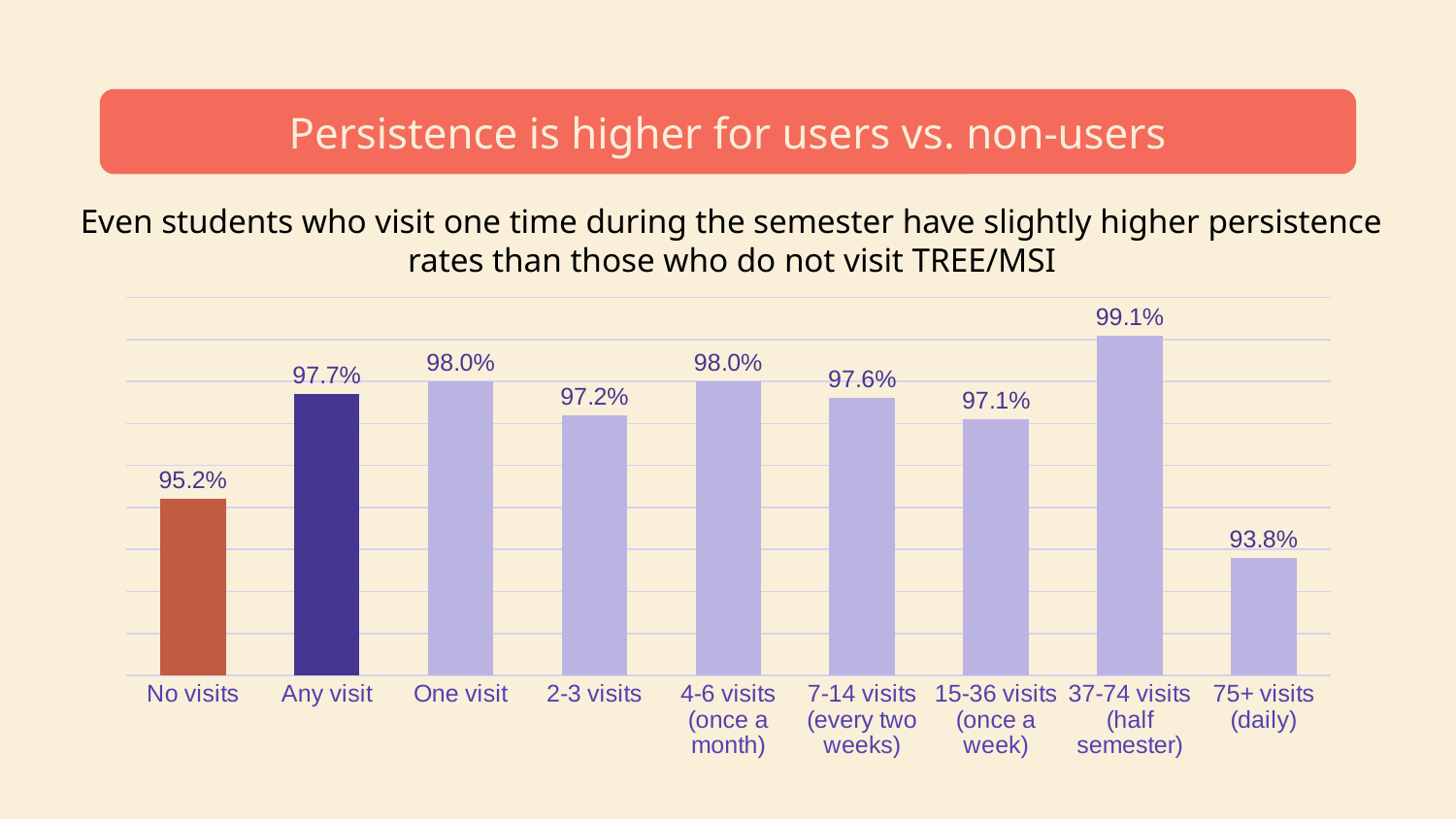
What is the persistence rate for students with any visit? 97.7% What is the persistence rate for students with 37-74 visits (half semester)? 99.1% What is the difference in persistence rate between Any visit and No visits? 2.5% Which has a higher persistence rate, One visit or 2-3 visits? One visit What is the title of the slide above the chart? Persistence is higher for users vs. non-users What is the persistence rate for students with 75+ visits (daily)? 93.8% What is the difference in persistence rate between 37-74 visits (half semester) and 75+ visits (daily)? 5.3% Which category has the highest persistence rate? 37-74 visits (half semester) What kind of chart is shown on the slide? Bar chart What is the persistence rate for students with no visits? 95.2% Which category has the lowest persistence rate? 75+ visits (daily) How many categories are shown on the x axis? 9